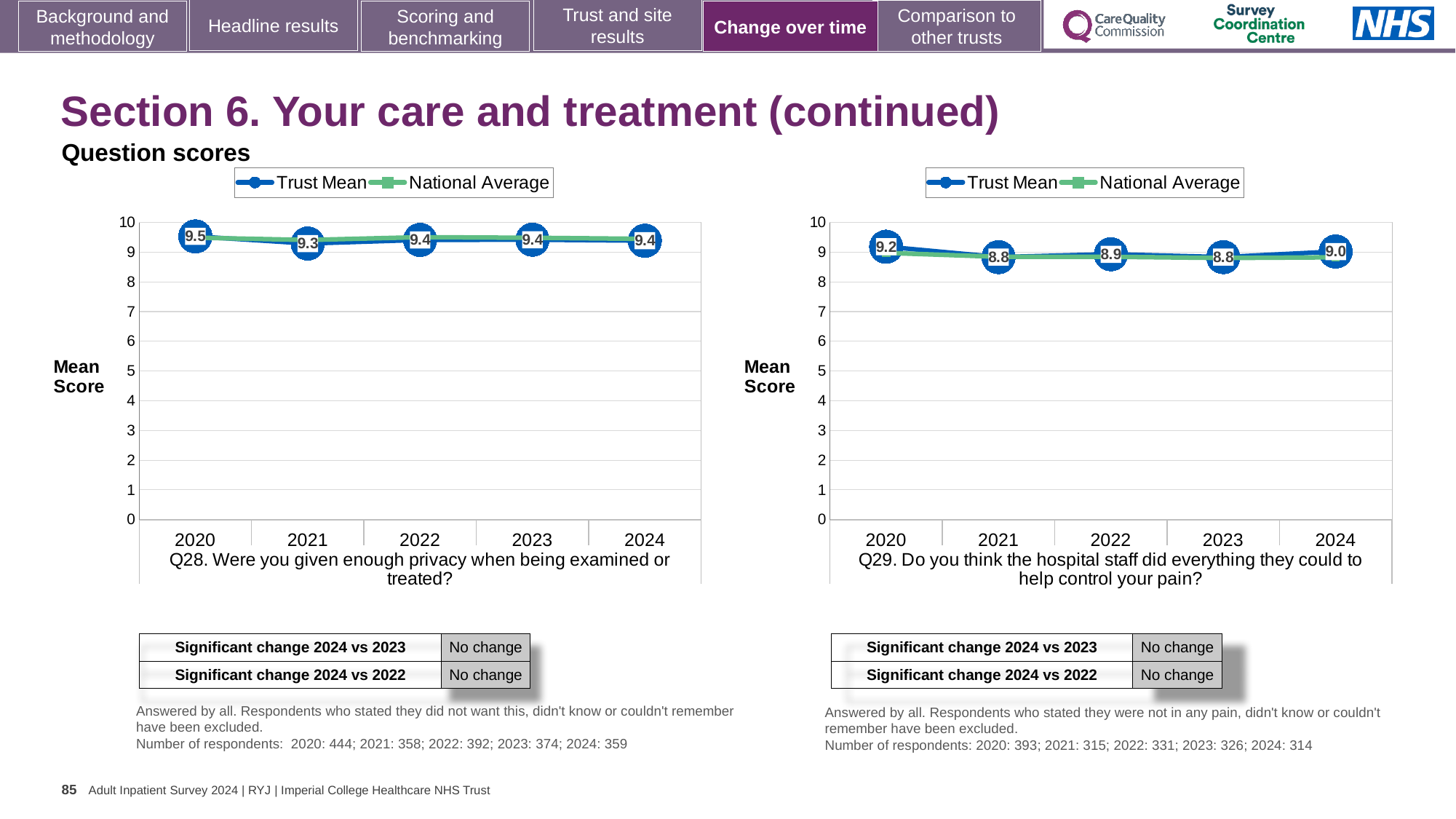
What type of chart is used for Q28 (left)? Line chart In the Q29 chart (right), what is the Trust Mean score for 2022? 8.9 How many years are plotted on the x axis of the Q28 chart (left)? 5 How many series does the legend of the Q29 chart (right) list? 2 In the Q29 chart (right), what is the Trust Mean score for 2024? 9.0 In the Q28 chart (left), what is the Trust Mean score for 2020? 9.5 In the Q28 chart (left), what is the Trust Mean score for 2021? 9.3 In the Q28 chart (left), which year has the highest Trust Mean score? 2020 In the Q28 chart (left), is the Trust Mean score for 2020 larger or smaller than the score for 2021? larger In the Q29 chart (right), is the Trust Mean value for 2021 greater or less than 9? less In the Q29 chart (right), which year has the highest Trust Mean score? 2020 In the Q29 chart (right), what is the difference between the Trust Mean scores for 2020 and 2021? 0.4